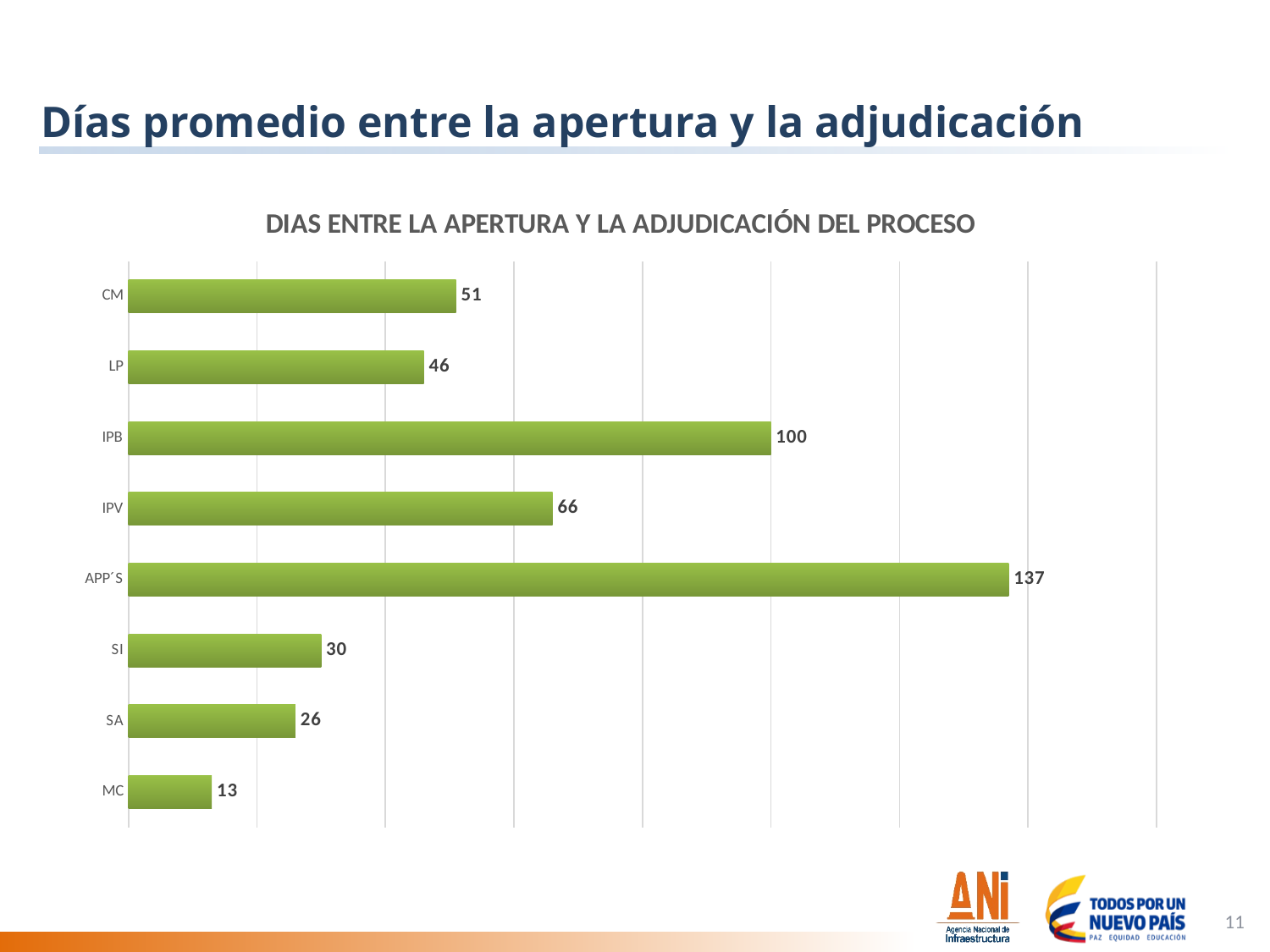
What is the value for MC? 13 Which is larger, the value for IPV or the value for SI? IPV What kind of chart is shown on the slide? Bar chart What is the difference between the values for APP´S and IPB? 37 What is the value for LP? 46 How many categories are shown in the chart? 8 Which category has the highest value? APP´S What is the title of the chart? DIAS ENTRE LA APERTURA Y LA ADJUDICACIÓN DEL PROCESO What is the value for APP´S? 137 What is the difference between the values for CM and LP? 5 What is the value for IPB? 100 Which category has the lowest value? MC